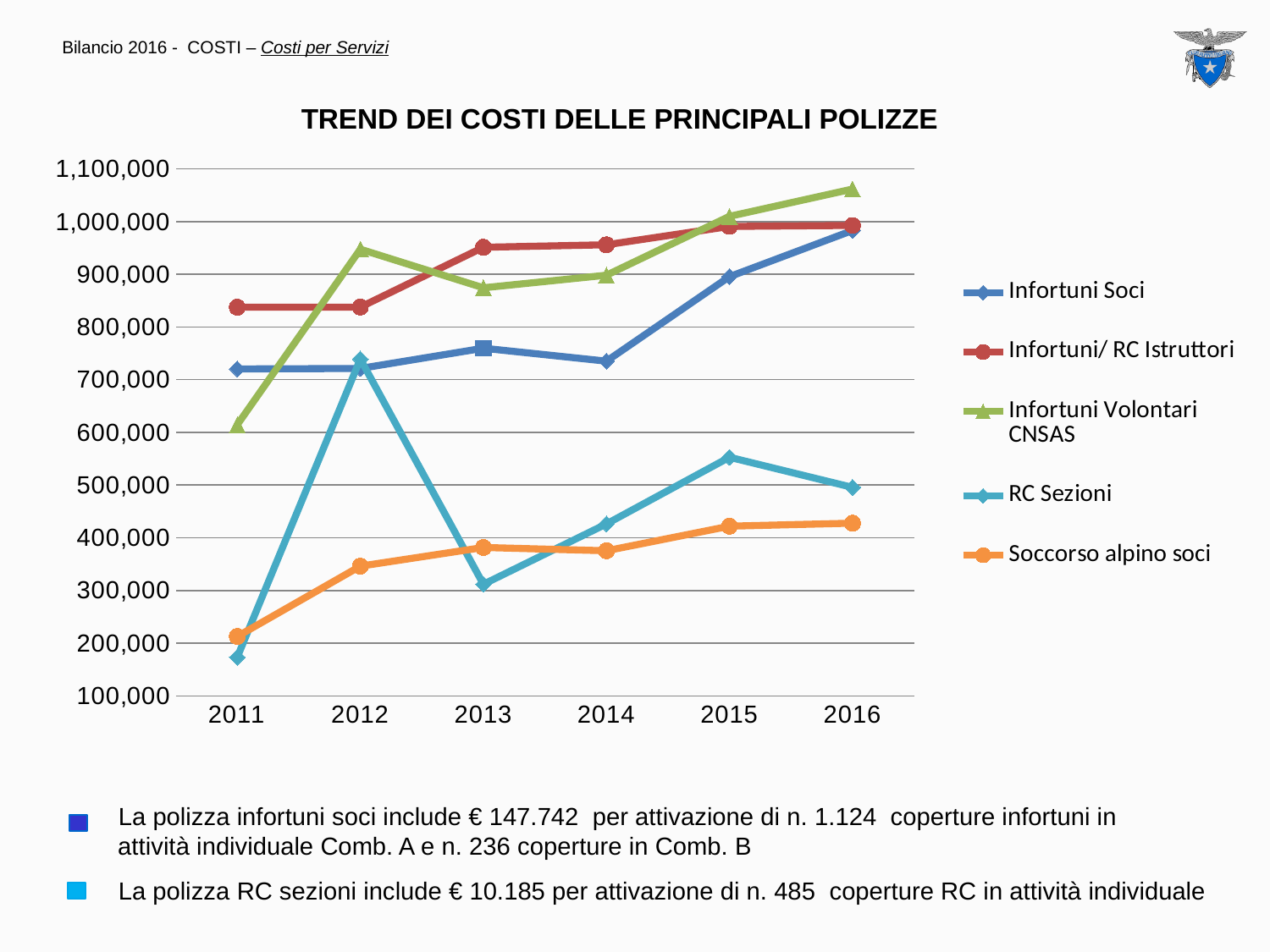
How many series does the legend list? 5 Is the value for RC Sezioni in 2011 greater or less than 200,000? less Is the value for Infortuni Volontari CNSAS in 2016 greater or less than 1,000,000? greater Is the value for Infortuni Soci in 2015 greater or less than 800,000? greater In 2014, which is larger: Infortuni Soci or Soccorso alpino soci? Infortuni Soci In which year does RC Sezioni reach its highest value? 2012 Which series has the lowest value in 2011? RC Sezioni Which series has the highest value in 2016? Infortuni Volontari CNSAS What is the title of the chart? TREND DEI COSTI DELLE PRINCIPALI POLIZZE Does the Soccorso alpino soci series rise or fall overall from 2011 to 2016? Rise How many years are shown on the x axis? 6 What kind of chart is shown on the slide? Line chart